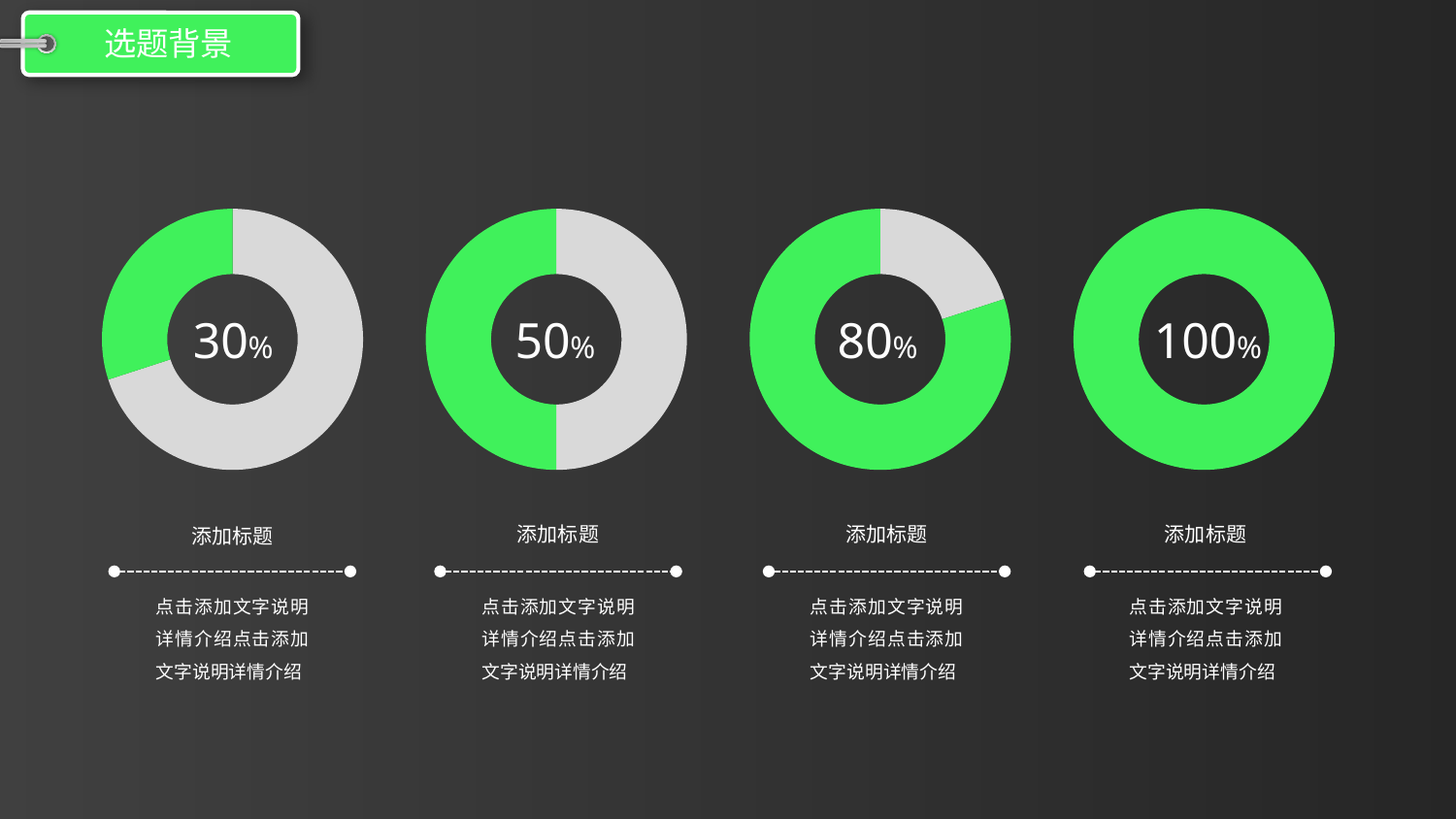
What colour is used for the filled (percentage) portion of each donut chart? Green What kind of chart is shown four times across the slide? Donut chart Do the percentages in the donut charts rise or fall from left to right across the slide? Rise What percentage is shown in the centre of the rightmost donut chart? 100% Which is larger, the percentage in the second donut chart from the left or the percentage in the third donut chart from the left? The third donut chart (80%) Which donut chart shows the highest percentage? The rightmost one (100%) What percentage is shown in the centre of the second donut chart from the left? 50% What percentage is shown in the centre of the third donut chart from the left? 80% How many donut charts are on the slide? 4 What is the difference between the percentage in the rightmost donut chart and the percentage in the leftmost donut chart? 70% What percentage is shown in the centre of the leftmost donut chart? 30% Which donut chart shows the lowest percentage? The leftmost one (30%)